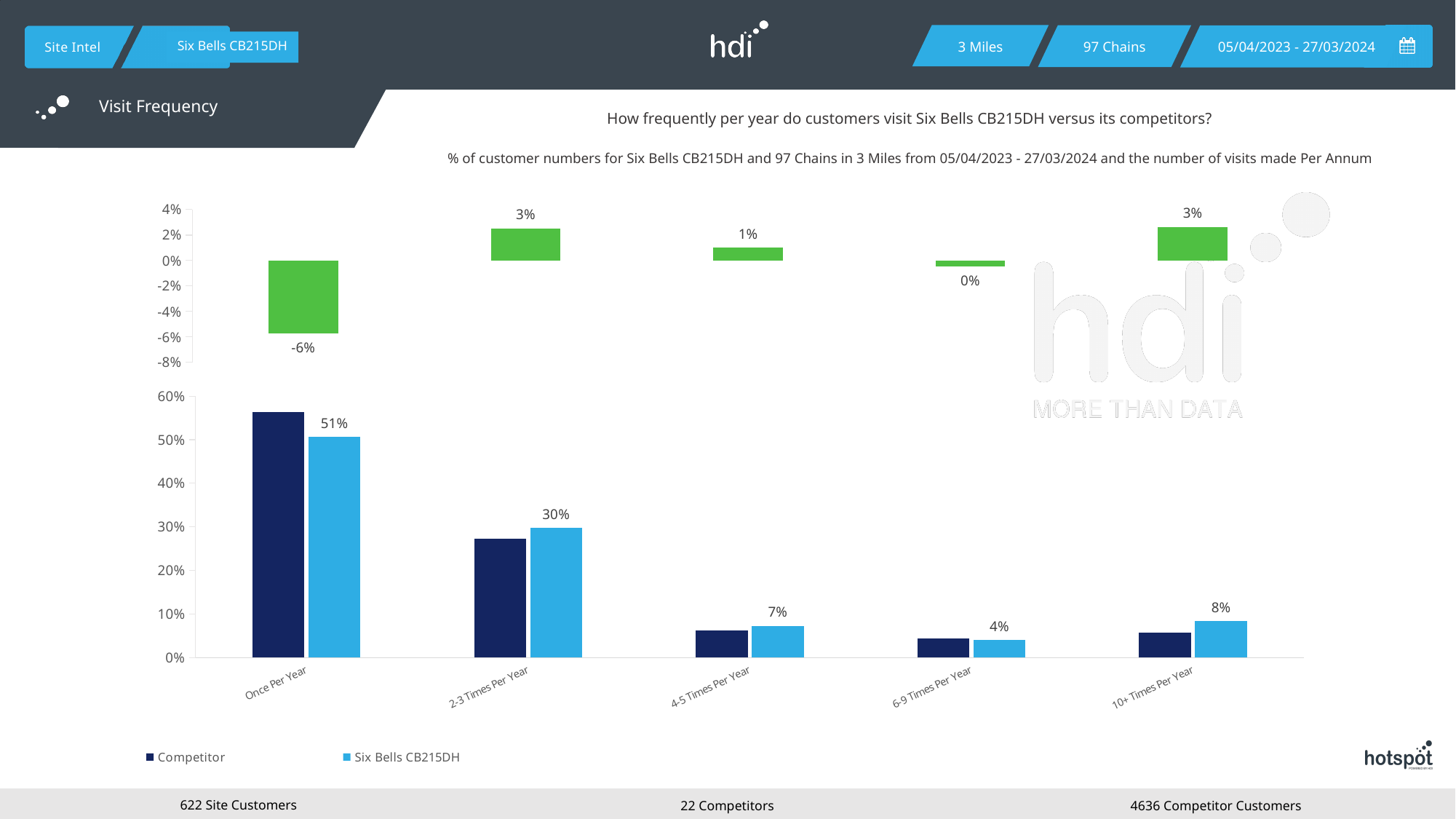
In the bottom bar chart, what is the value for Six Bells CB215DH for 2-3 Times Per Year? 30% In the top green chart, what is the value for Once Per Year? -6% How many series does the legend of the bottom bar chart list? 2 In the bottom bar chart, for Once Per Year, which is larger: Competitor or Six Bells CB215DH? Competitor In the bottom bar chart, is the Competitor value for Once Per Year greater or less than 50%? greater In the bottom bar chart, what is the value for Six Bells CB215DH for Once Per Year? 51% In the bottom bar chart, what is the value for Six Bells CB215DH for 10+ Times Per Year? 8% In the bottom bar chart, which category has the highest value for Six Bells CB215DH? Once Per Year How many categories are shown on the x axis of the bottom bar chart? 5 In the bottom bar chart, what is the difference between the Six Bells CB215DH values for Once Per Year and 2-3 Times Per Year? 21% In the top green chart, which category has the lowest value? Once Per Year In the bottom bar chart, which category has the lowest value for Six Bells CB215DH? 6-9 Times Per Year